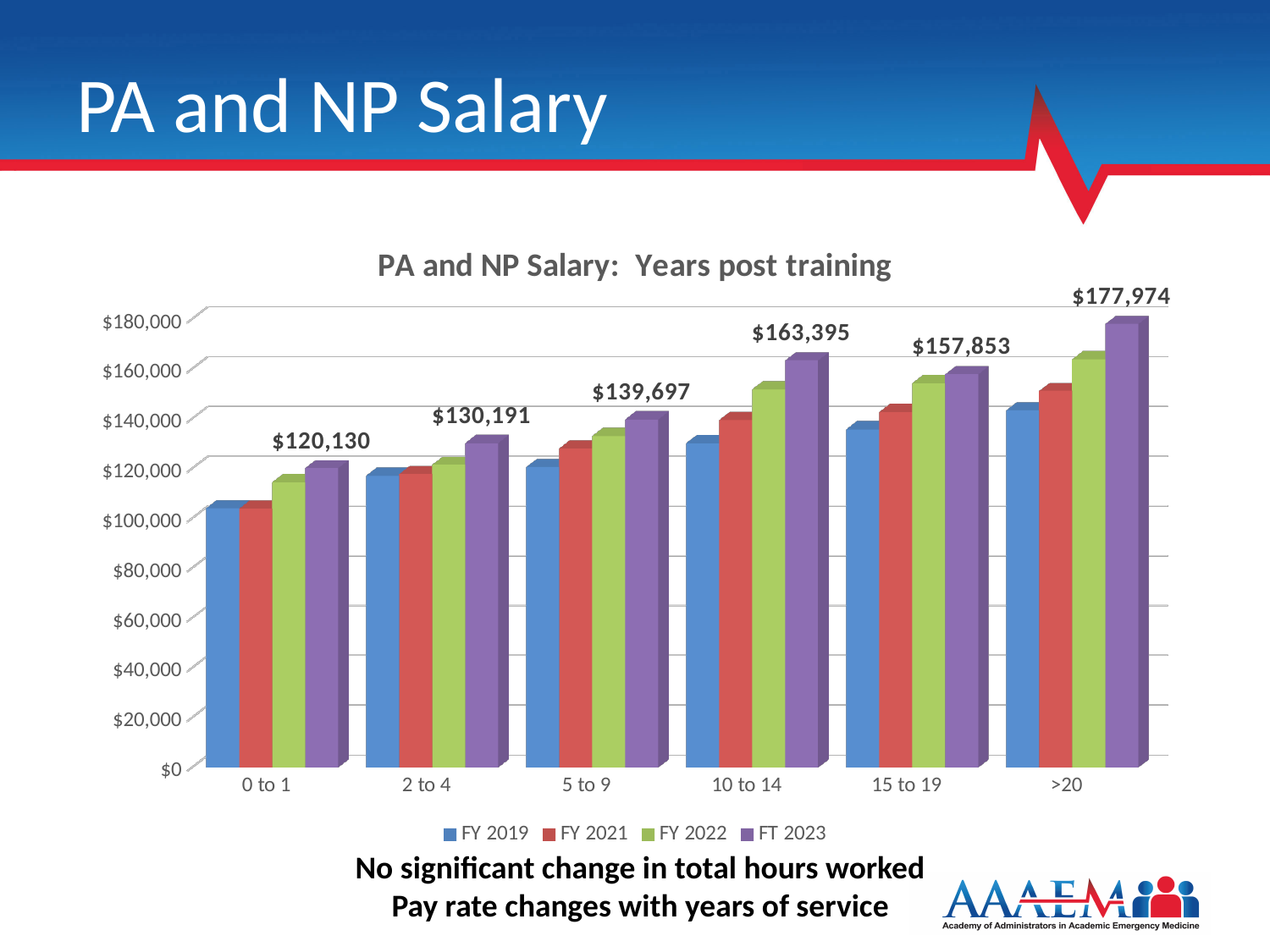
What is the FT 2023 value for the >20 years category? $177,974 What is the FT 2023 value for the 0 to 1 years category? $120,130 How many years-post-training categories are shown on the x axis? 6 What kind of chart is shown on the slide? bar chart Which years-post-training category has the highest FT 2023 salary? >20 Is the FY 2019 value for the 0 to 1 years category greater or less than $120,000? less How many series does the legend list? 4 For FT 2023, which is larger: the value for 10 to 14 years or for 15 to 19 years? 10 to 14 What is the difference between the FT 2023 values for >20 and 0 to 1 years? $57,844 What is the FT 2023 value for the 10 to 14 years category? $163,395 Which years-post-training category has the lowest FT 2023 salary? 0 to 1 What is the difference between the FT 2023 values for 10 to 14 and 15 to 19 years? $5,542